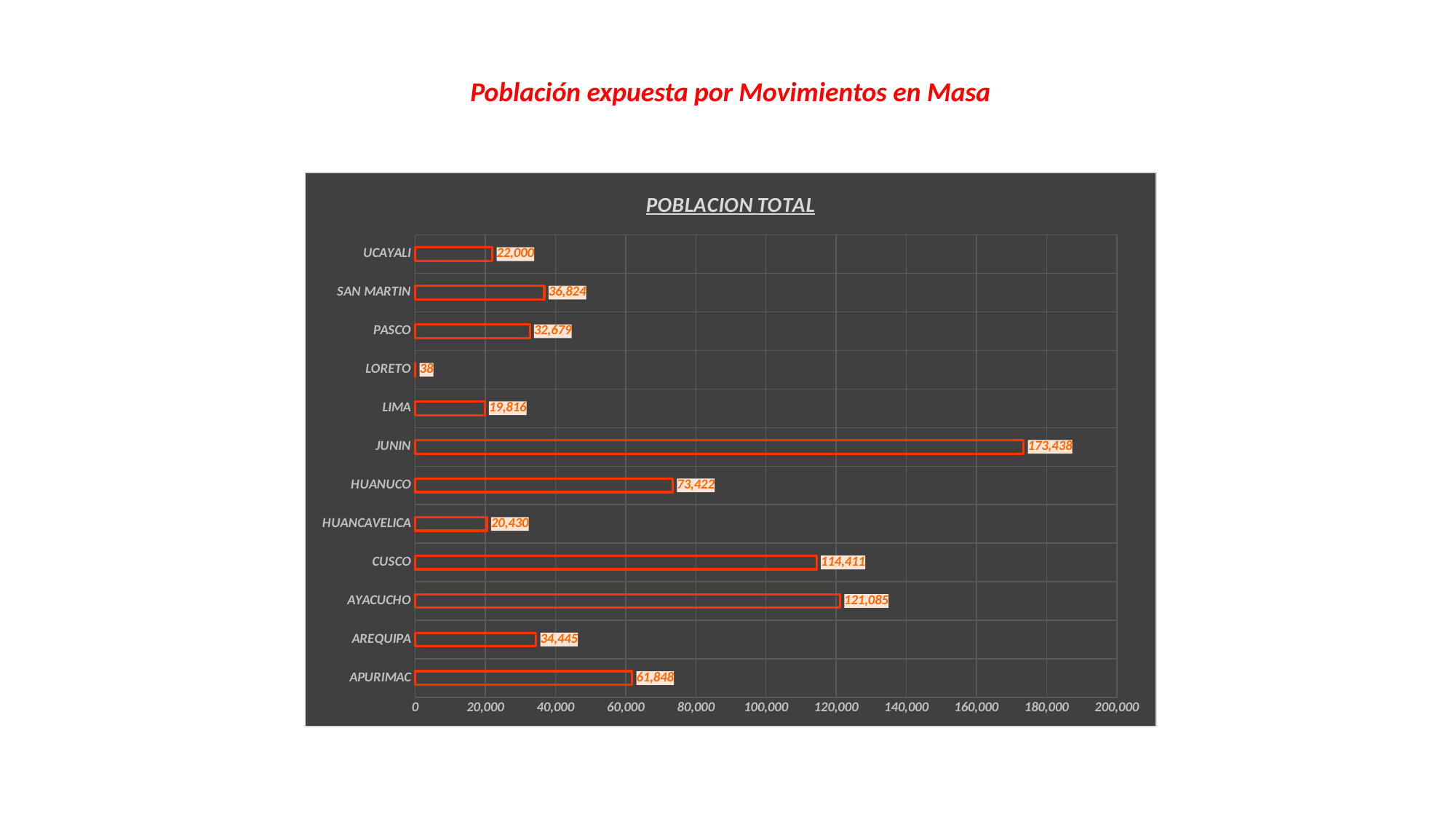
What is the difference between the values for AYACUCHO and CUSCO? 6,674 What is the title of the chart? POBLACION TOTAL Is the value for AREQUIPA greater or less than 40,000? less What is the difference between the values for SAN MARTIN and PASCO? 4,145 Which region has the highest value? JUNIN What kind of chart is shown? bar chart What is the value for LORETO? 38 What is the value for CUSCO? 114,411 How many regions are shown in the chart? 12 What is the value for JUNIN? 173,438 Which region has the lowest value? LORETO Which is larger, the value for HUANUCO or the value for APURIMAC? HUANUCO